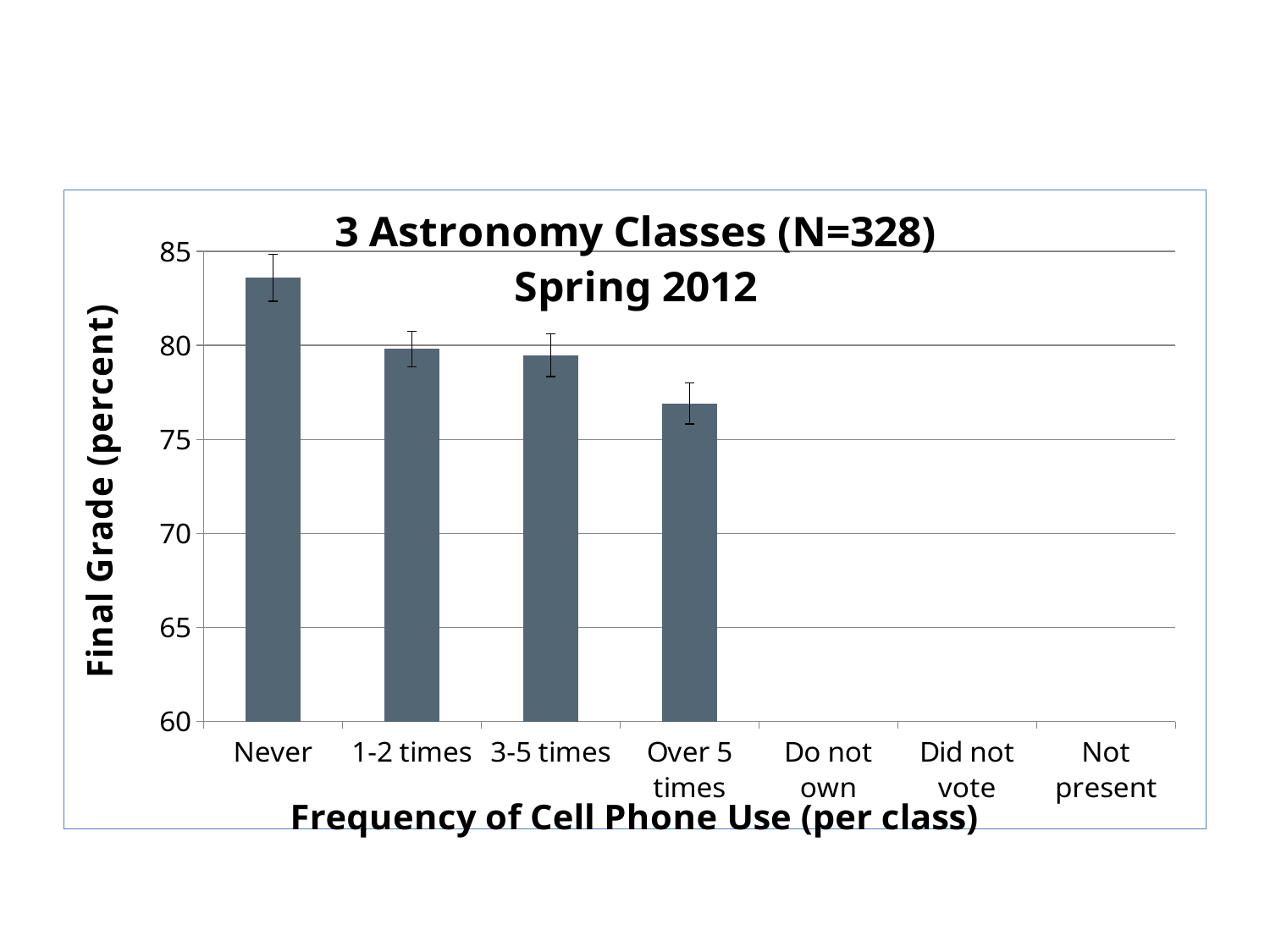
What is the title of the y axis? Final Grade (percent) Among the categories with a plotted bar, which has the lowest final grade? Over 5 times Which category has the highest final grade? Never Is the value for Never greater or less than 80? greater Do the bar values rise or fall from Never to Over 5 times? fall Which has a higher final grade, Never or Over 5 times? Never Is the value for 1-2 times greater or less than 75? greater What kind of chart is shown on the slide? bar chart Is the value for Over 5 times greater or less than 80? less How many categories are labelled on the x axis? 7 How many bars are plotted on the chart? 4